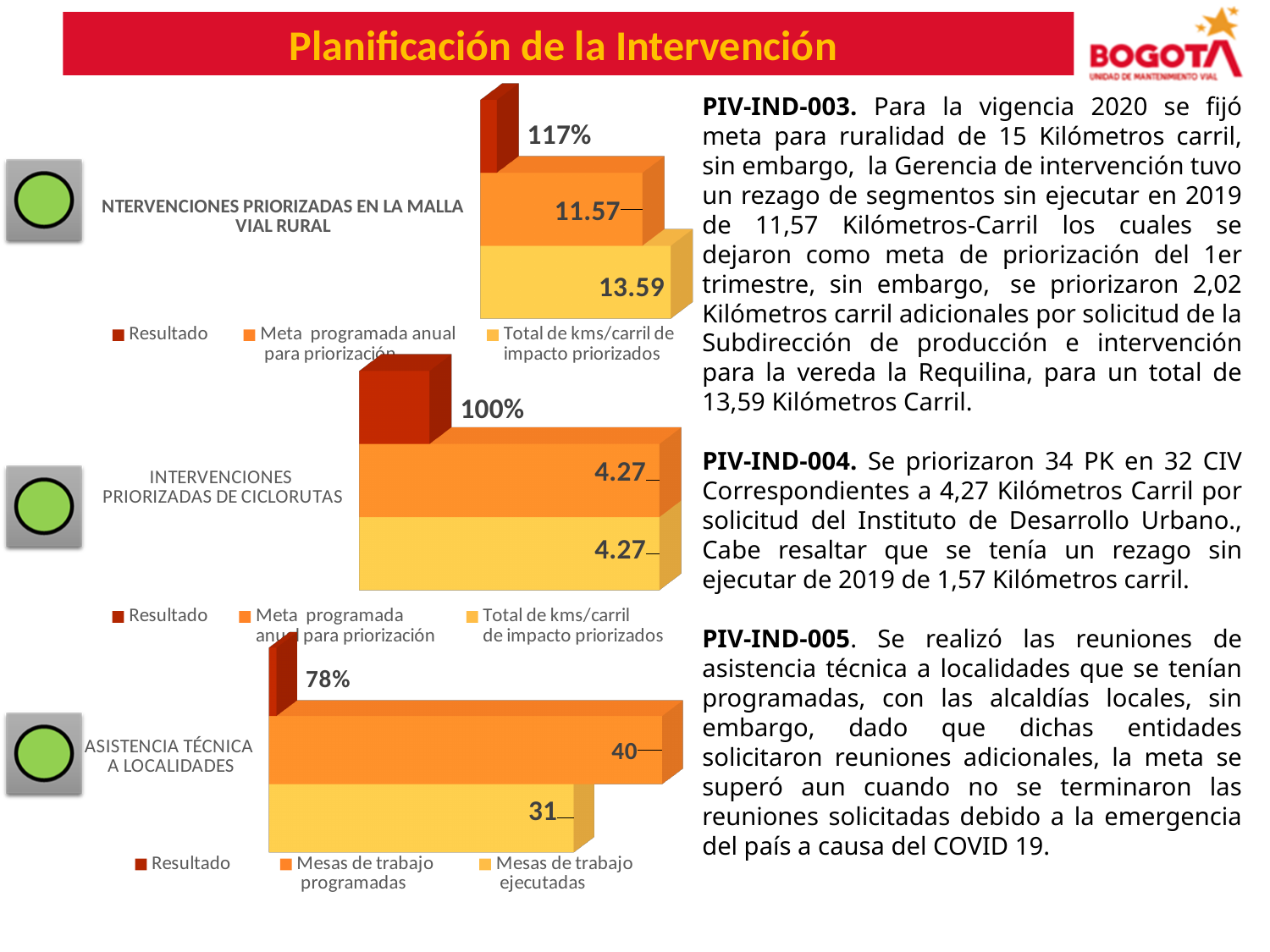
In the middle chart (Intervenciones priorizadas de ciclorutas), what is the value for Meta programada anual para priorización? 4.27 In the bottom chart (Asistencia técnica a localidades), what is the difference between Mesas de trabajo programadas and Mesas de trabajo ejecutadas? 9 What kind of chart is the top chart (Intervenciones priorizadas en la malla vial rural)? Bar chart In the bottom chart (Asistencia técnica a localidades), what is the value for Mesas de trabajo ejecutadas? 31 In the bottom chart (Asistencia técnica a localidades), what is the value for Mesas de trabajo programadas? 40 In the top chart (Intervenciones priorizadas en la malla vial rural), what is the value for Resultado? 117% In the bottom chart (Asistencia técnica a localidades), which is larger: Mesas de trabajo programadas or Mesas de trabajo ejecutadas? Mesas de trabajo programadas In the middle chart (Intervenciones priorizadas de ciclorutas), what is the value for Resultado? 100% How many series does the legend of the bottom chart (Asistencia técnica a localidades) list? 3 In the top chart (Intervenciones priorizadas en la malla vial rural), what is the value for Meta programada anual para priorización? 11.57 In the top chart (Intervenciones priorizadas en la malla vial rural), what is the value for Total de kms/carril de impacto priorizados? 13.59 In the top chart (Intervenciones priorizadas en la malla vial rural), what is the difference between Total de kms/carril de impacto priorizados and Meta programada anual para priorización? 2.02